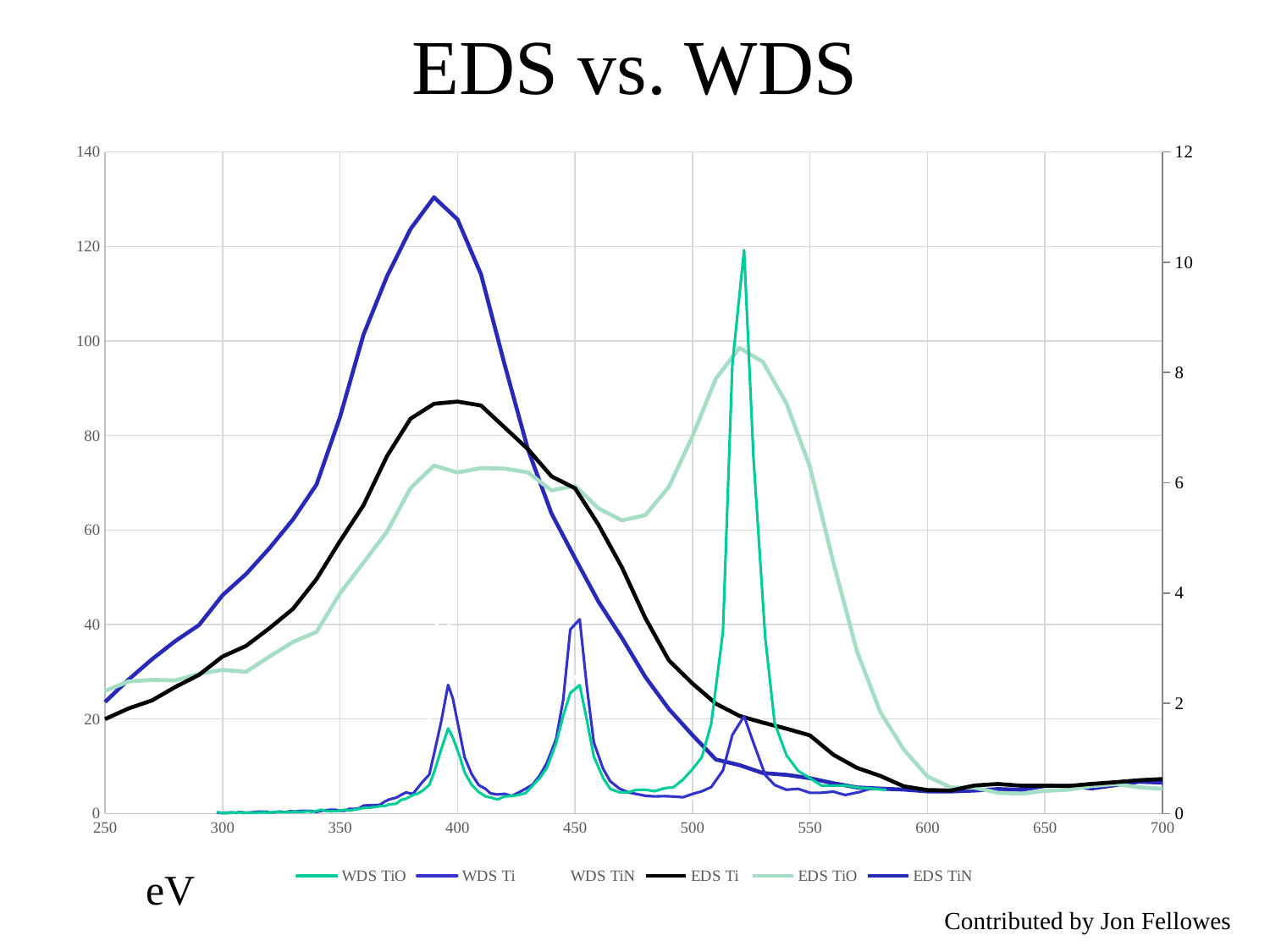
At 400 eV, which is higher: EDS Ti or EDS TiO? EDS Ti Is the peak of the EDS Ti series greater or less than 80 on the left axis? greater Is the peak of the EDS TiO series greater or less than 90 on the left axis? greater Does the EDS TiO series rise or fall between 550 and 600 eV? fall How many series does the legend list? 6 At 520 eV, which is higher: EDS TiO or EDS Ti? EDS TiO What is the title of the chart? EDS vs. WDS What is the highest tick value on the right y axis? 12 What kind of chart is shown on the slide? line chart What is the highest tick value on the left y axis? 140 What unit is labelled on the x axis of the chart? eV Does the EDS Ti series rise or fall between 300 and 400 eV? rise